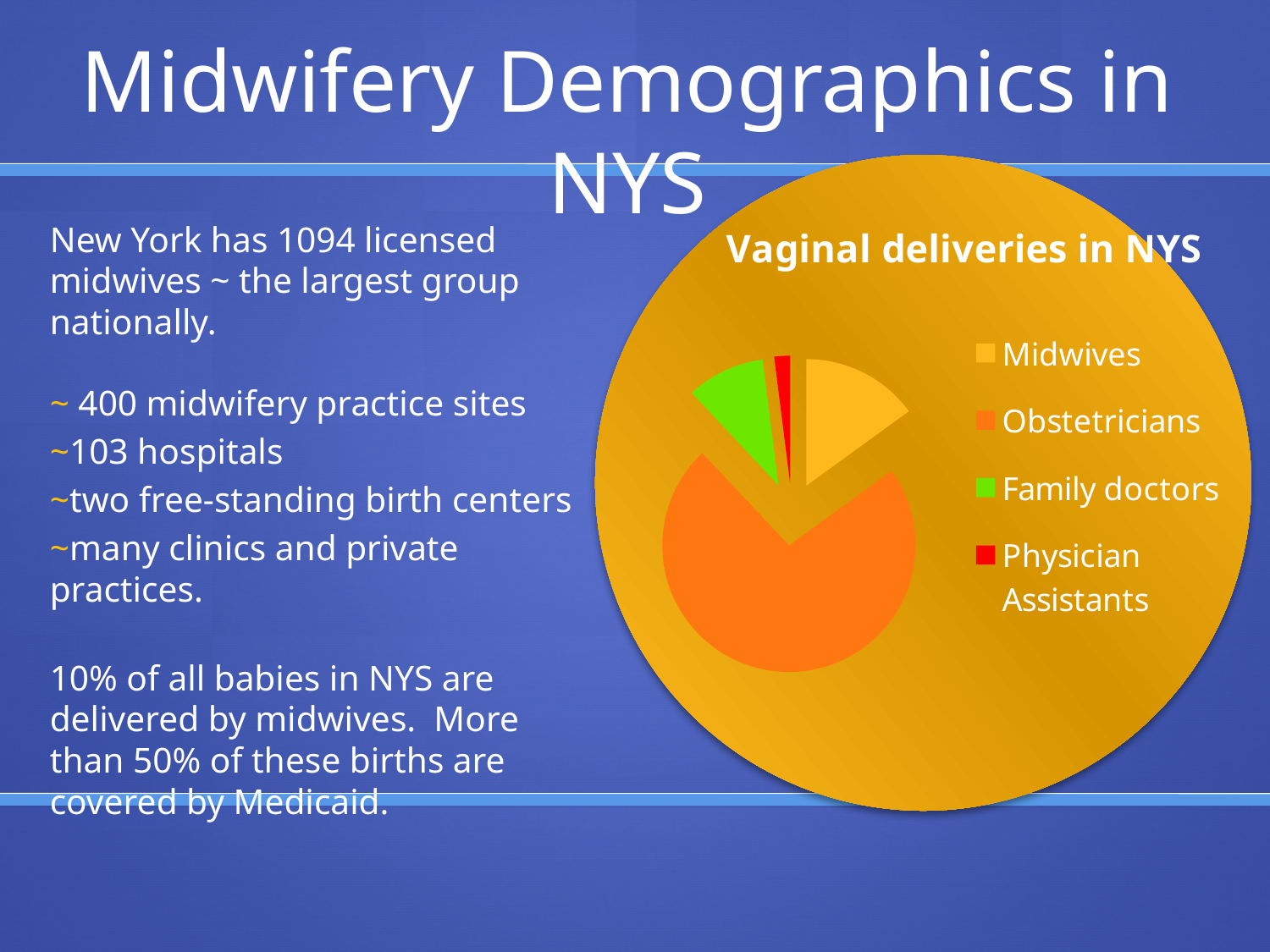
What colour represents Family doctors in the pie chart? Green Which slice is larger, Midwives or Family doctors? Midwives Which category has the smallest slice of the pie? Physician Assistants What kind of chart is shown on the slide? Pie chart Which slice is larger, Family doctors or Physician Assistants? Family doctors Which slice is larger, Obstetricians or Midwives? Obstetricians What is the title of the chart? Vaginal deliveries in NYS Which category has the largest slice of the pie? Obstetricians How many categories does the pie chart show? 4 Which category is shown in red in the pie chart? Physician Assistants